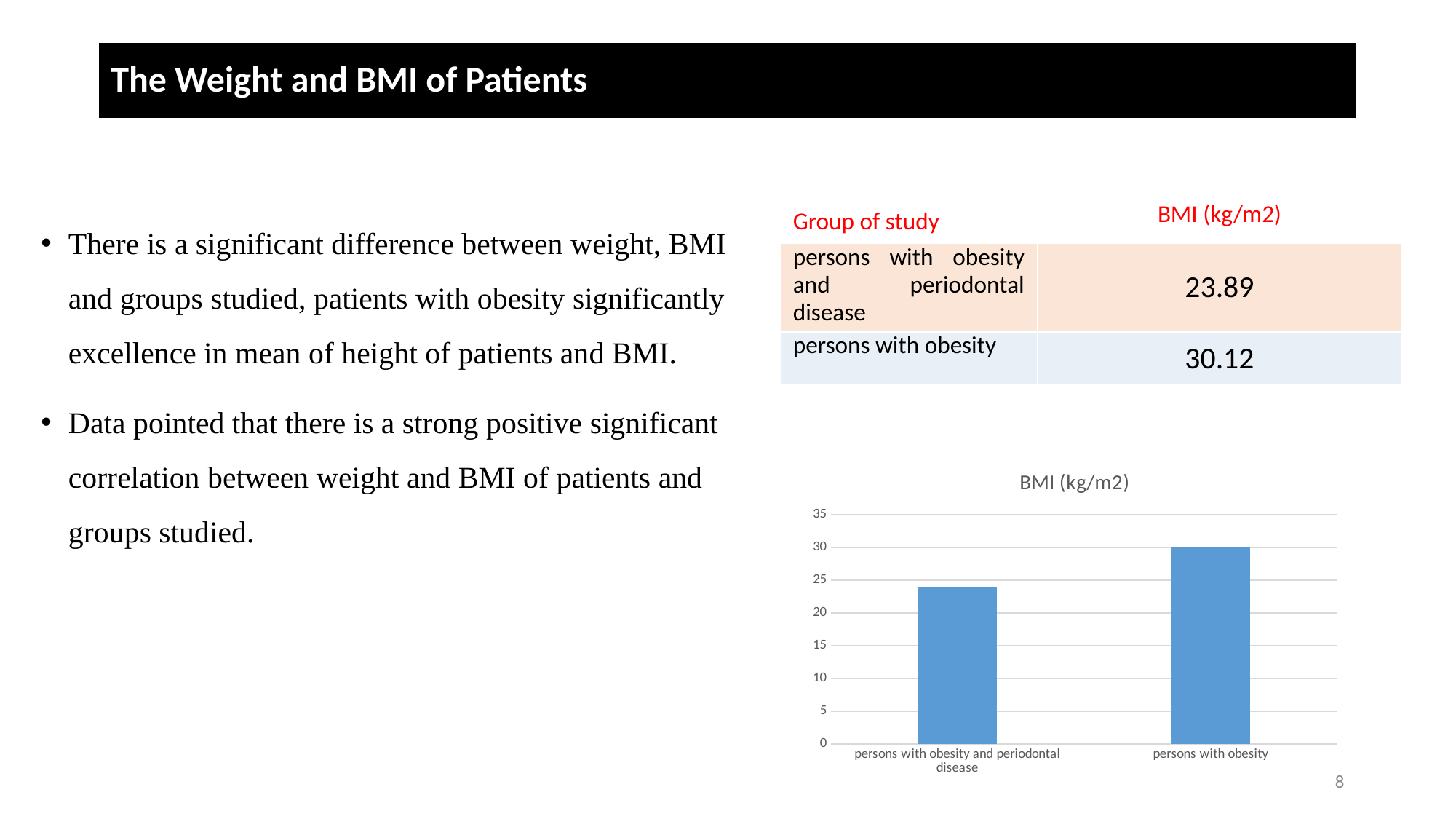
Is the BMI value for persons with obesity greater or less than 25? greater Is the BMI value for persons with obesity and periodontal disease greater or less than 20? greater According to the table on the slide, what is the BMI (kg/m2) for persons with obesity and periodontal disease? 23.89 Using the values in the table, what is the difference in BMI between persons with obesity and persons with obesity and periodontal disease? 6.23 According to the table on the slide, what is the BMI (kg/m2) for persons with obesity? 30.12 Which category has the lowest BMI in the chart? persons with obesity and periodontal disease How many categories are plotted in the chart? 2 What type of chart is shown on the slide? bar chart Which category has the highest BMI in the chart? persons with obesity Which is larger, the BMI for persons with obesity or for persons with obesity and periodontal disease? persons with obesity Is the BMI value for persons with obesity and periodontal disease greater or less than 25? less What is the title of the chart? BMI (kg/m2)